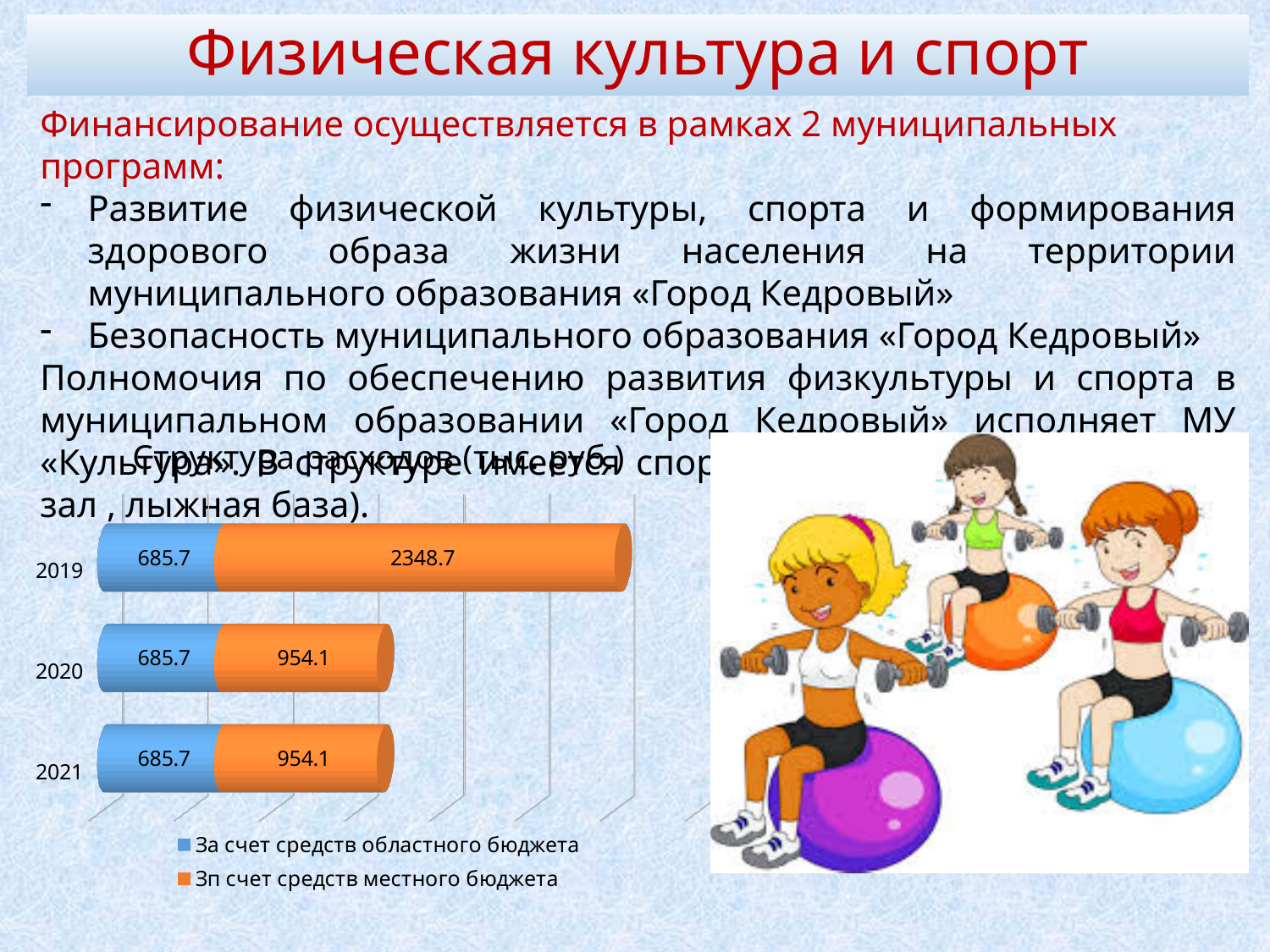
What is the value for 'За счет средств областного бюджета' in 2019? 685.7 What is the total of the stacked bar for 2019? 3034.4 What is the total of the stacked bar for 2021? 1639.8 What kind of chart is shown on the slide? Stacked bar chart What is the difference between the 'Зп счет средств местного бюджета' values for 2019 and 2020? 1394.6 Which is larger in 2020: 'За счет средств областного бюджета' or 'Зп счет средств местного бюджета'? Зп счет средств местного бюджета What is the value for 'Зп счет средств местного бюджета' in 2019? 2348.7 What is the value for 'Зп счет средств местного бюджета' in 2020? 954.1 How many series does the legend list? 2 Which year has the highest value for 'Зп счет средств местного бюджета'? 2019 What is the value for 'За счет средств областного бюджета' in 2021? 685.7 How many years are shown on the chart? 3